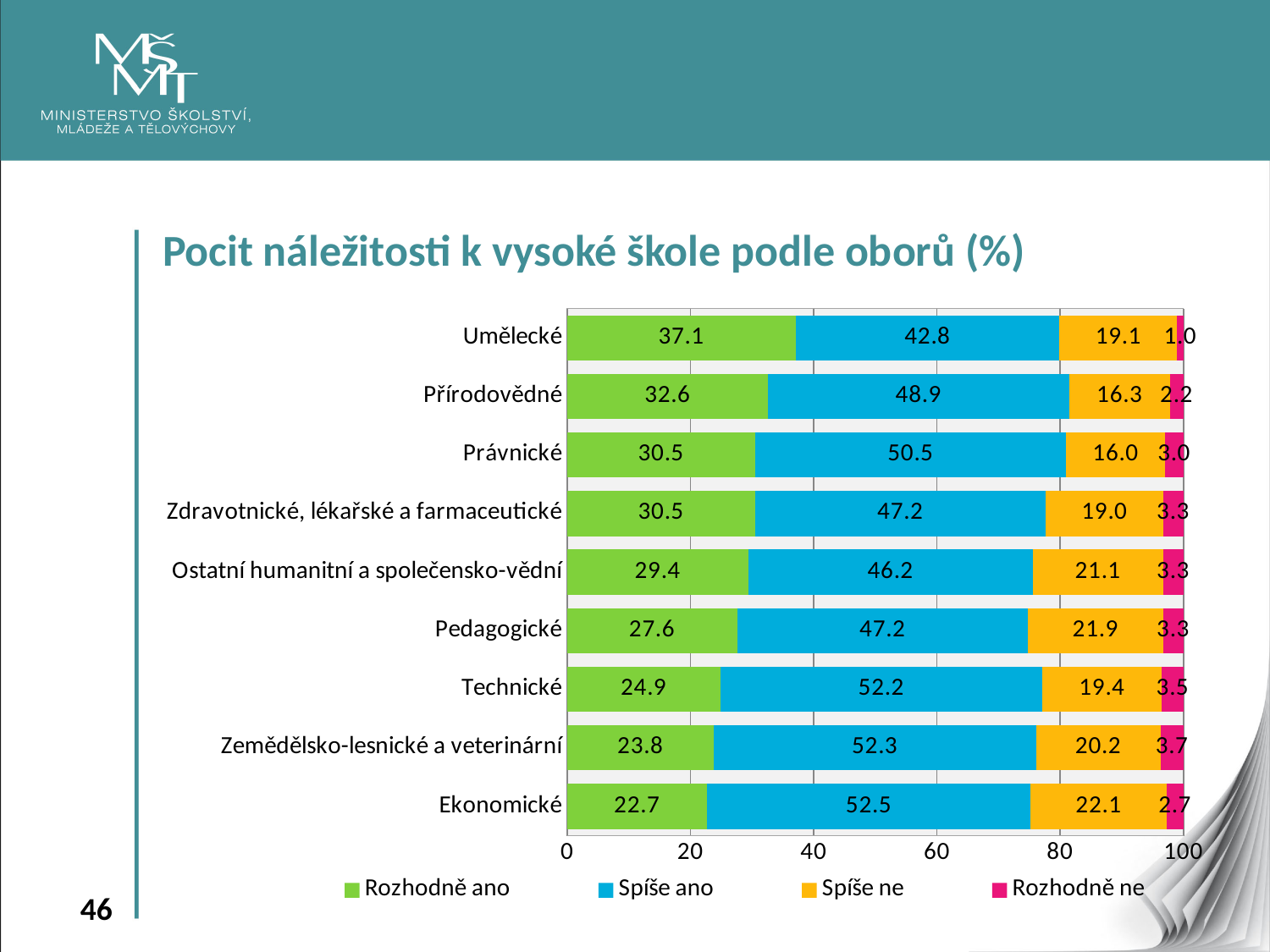
What is the difference between the "Rozhodně ano" values for Umělecké and Ekonomické? 14.4 How many fields (categories) are shown in the chart? 9 Which is larger: the "Spíše ano" value for Technické or for Umělecké? Technické Which field has the highest value for "Rozhodně ano"? Umělecké What is the value of "Rozhodně ne" for Zemědělsko-lesnické a veterinární? 3.7 Which field has the lowest value for "Rozhodně ano"? Ekonomické Which field has the lowest value for "Rozhodně ne"? Umělecké How many series does the legend list? 4 What is the value of "Spíše ano" for Právnické? 50.5 What is the value of "Rozhodně ano" for Umělecké? 37.1 What type of chart is shown on the slide? Stacked bar chart What is the value of "Spíše ne" for Pedagogické? 21.9